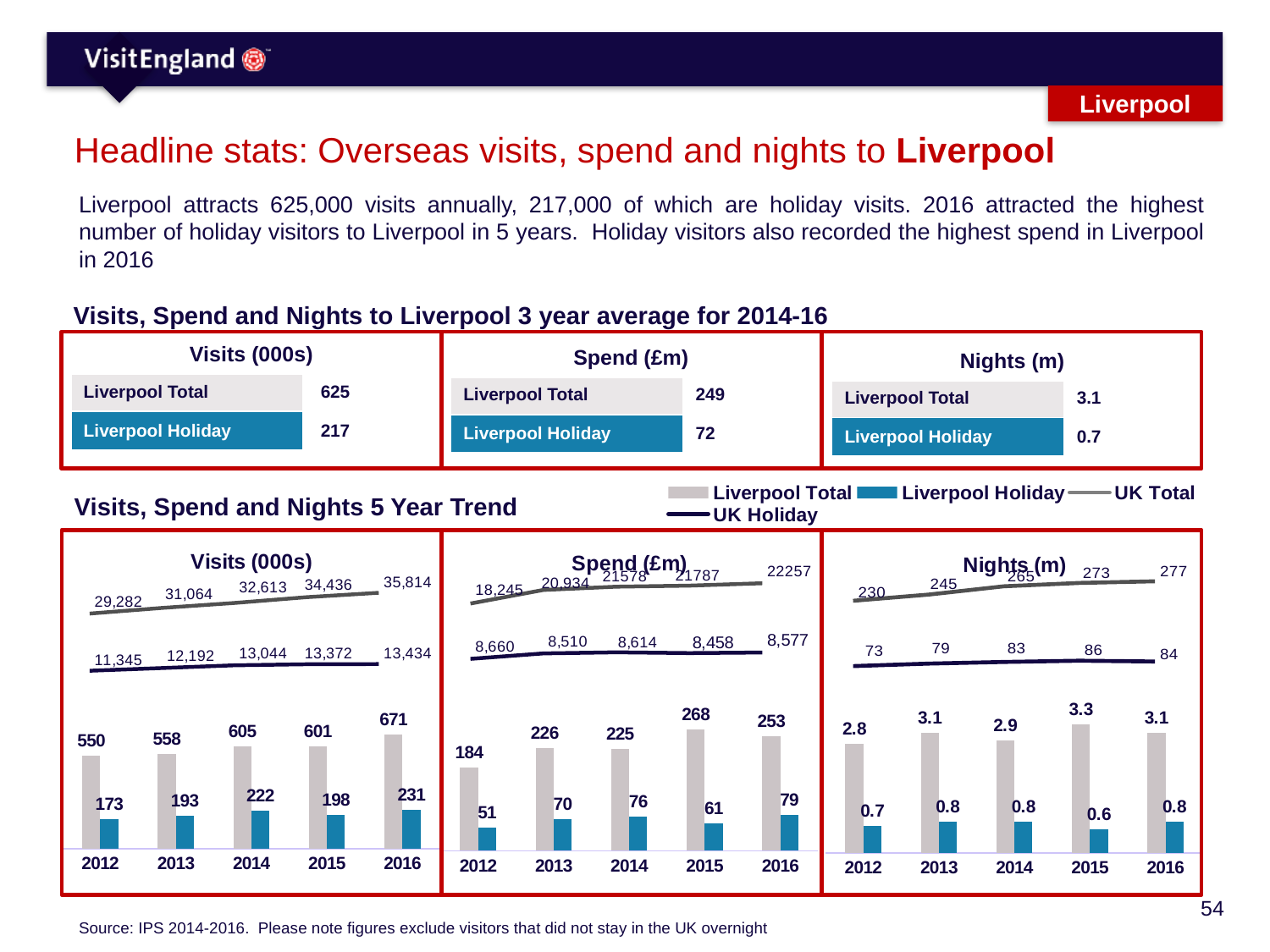
In the Nights (m) 5 year trend chart, which year has the lowest Liverpool Holiday value? 2015 In the Visits (000s) 5 year trend chart, what is the difference between the Liverpool Total values for 2016 and 2012? 121 How many series does the legend for the 5 Year Trend charts list? 4 In the Visits (000s) 5 year trend chart, what is the UK Total value for 2014? 32,613 In the Visits (000s) 5 year trend chart, which year has the highest Liverpool Holiday value? 2016 In the Nights (m) 5 year trend chart, what is the UK Total value for 2016? 277 How many years are shown on the x axis of the Nights (m) 5 year trend chart? 5 In the Spend (£m) 5 year trend chart, which year has the highest Liverpool Total value? 2015 In the Spend (£m) 5 year trend chart, what is the UK Holiday value for 2012? 8,660 In the Visits (000s) 5 year trend chart, what is the Liverpool Total value for 2016? 671 In the Spend (£m) 5 year trend chart, what is the Liverpool Holiday value for 2015? 61 In the Spend (£m) 5 year trend chart, which is larger, the Liverpool Total value for 2013 or for 2016? 2016